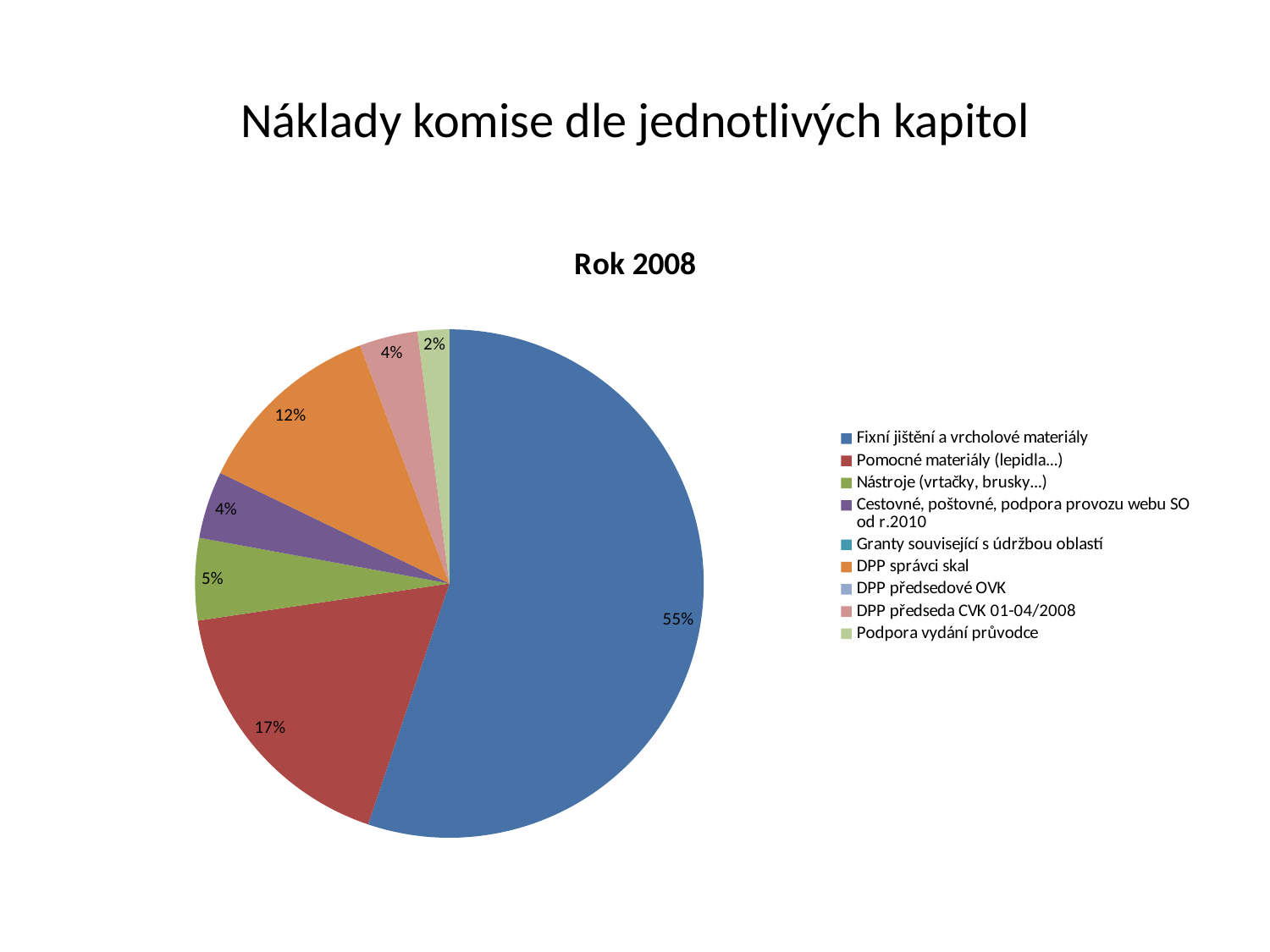
What colour is the slice for DPP správci skal? orange What is the difference in percentage points between the Fixní jištění a vrcholové materiály slice and the Pomocné materiály (lepidla…) slice? 38 What share of the pie is Pomocné materiály (lepidla…)? 17% What share of the pie is DPP správci skal? 12% What share of the pie is Fixní jištění a vrcholové materiály? 55% What is the title of the chart? Rok 2008 What kind of chart is shown on the slide? pie chart Which is larger, the slice for Pomocné materiály (lepidla…) or the slice for DPP správci skal? Pomocné materiály (lepidla…) Which category has the largest slice of the pie? Fixní jištění a vrcholové materiály How many entries does the legend list? 9